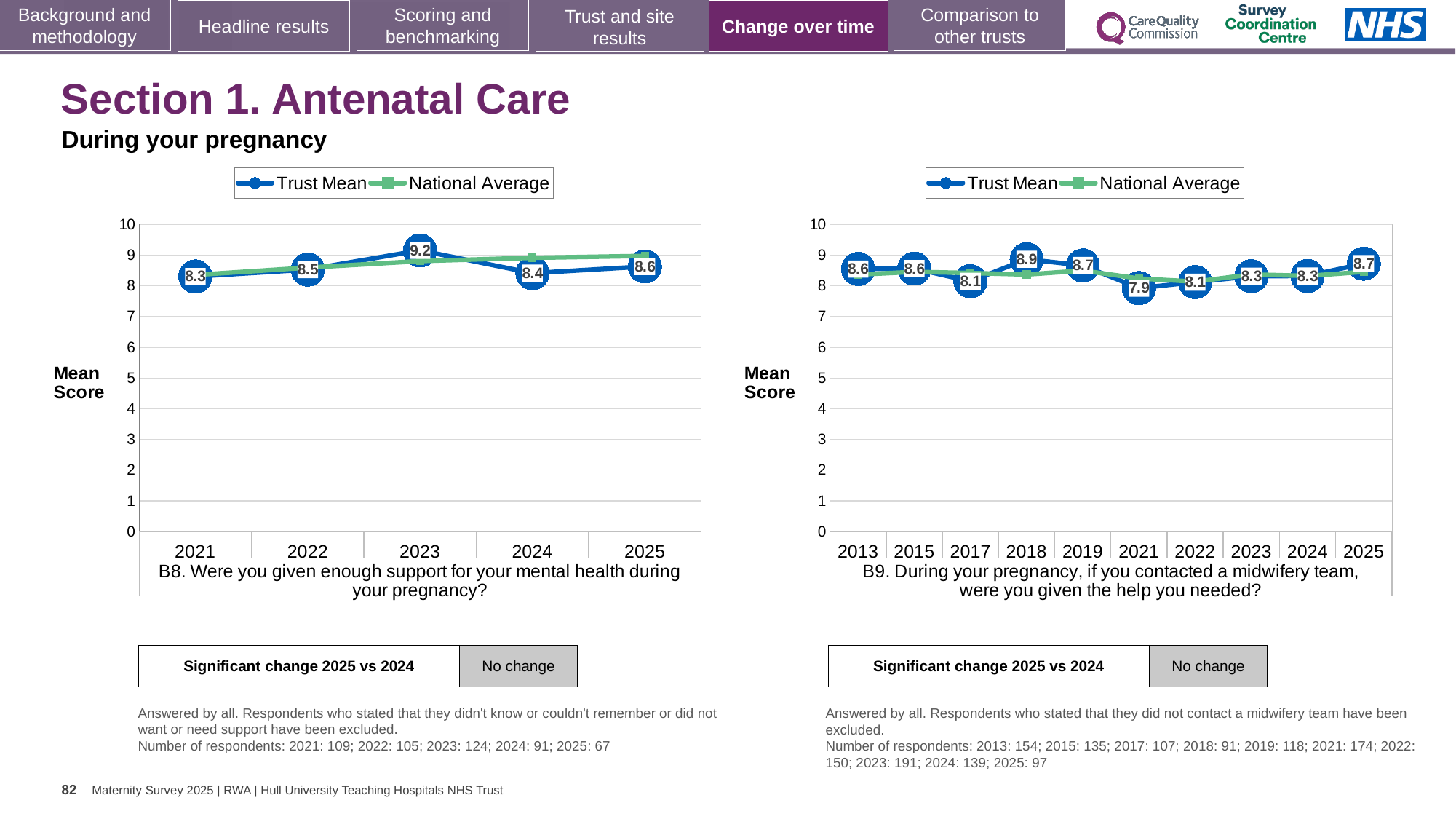
How many series does the legend of the B8 chart (left) list? 2 In the B9 chart (right), what is the Trust Mean for 2021? 7.9 In the B9 chart (right), which year has the lowest Trust Mean? 2021 In the B8 chart (left), how many years are shown on the x axis? 5 What kind of chart is the B9 chart (right)? Line chart In the B8 chart (left), what is the Trust Mean for 2021? 8.3 In the B8 chart (left), what is the difference between the Trust Mean for 2023 and 2024? 0.8 In the B9 chart (right), is the Trust Mean for 2018 or 2022 larger? 2018 In the B9 chart (right), which year has the highest Trust Mean? 2018 In the B9 chart (right), how many years are shown on the x axis? 10 In the B8 chart (left), what is the Trust Mean for 2023? 9.2 In the B8 chart (left), which year has the highest Trust Mean? 2023